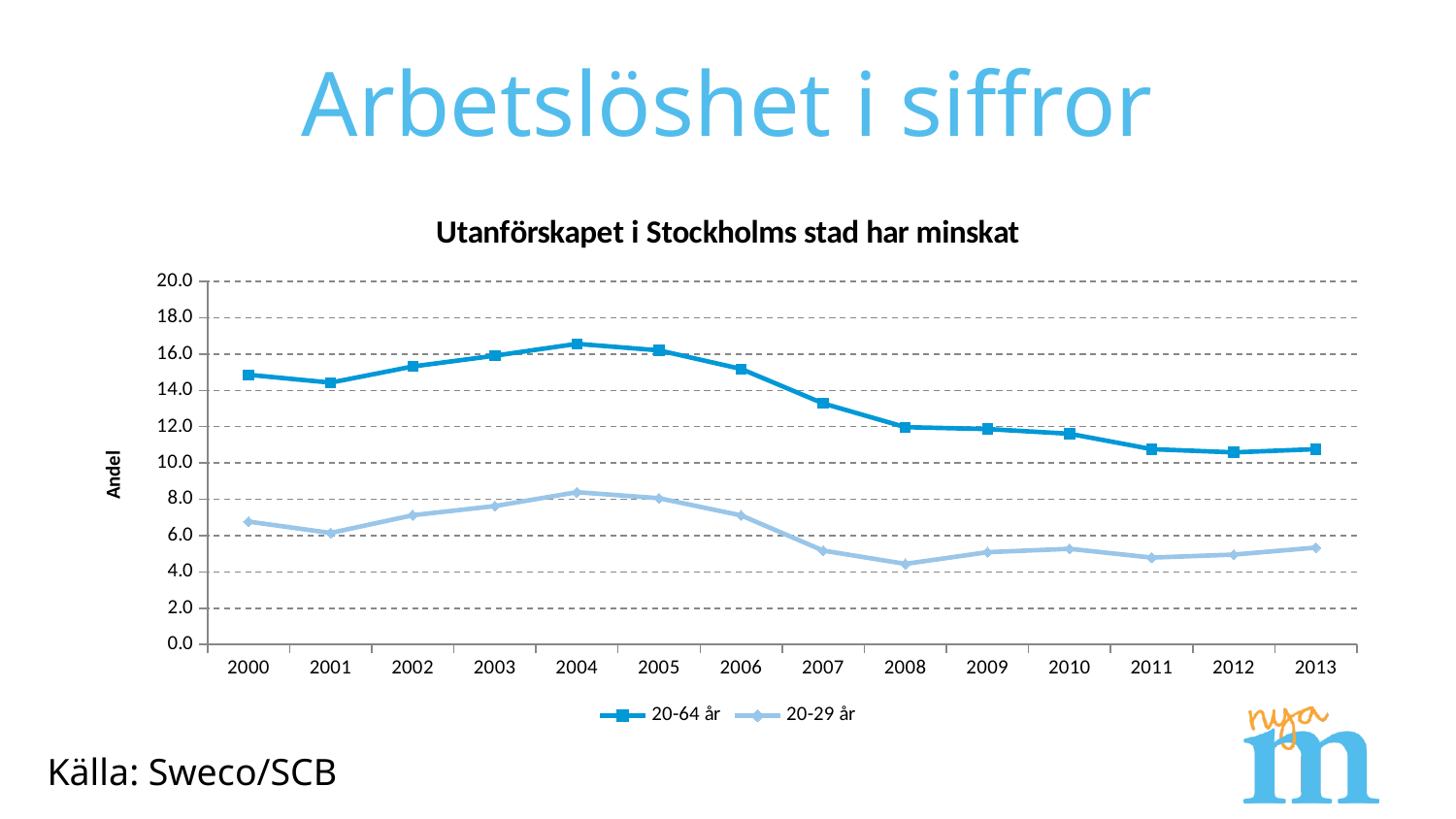
What is the title of the chart? Utanförskapet i Stockholms stad har minskat In which year does the 20-29 år series reach its lowest value? 2008 Which series has the larger value in 2010, 20-64 år or 20-29 år? 20-64 år Does the 20-64 år series rise or fall from 2005 to 2013? fall What kind of chart is shown on the slide? line chart How many series does the legend list? 2 Is the value for 20-29 år in 2008 greater or less than 6.0? less How many years are shown on the x axis? 14 Is the value for 20-64 år in 2013 greater or less than 12.0? less In which year does the 20-64 år series reach its highest value? 2004 What is the label on the y axis? Andel Is the value for 20-64 år in 2004 greater or less than 16.0? greater